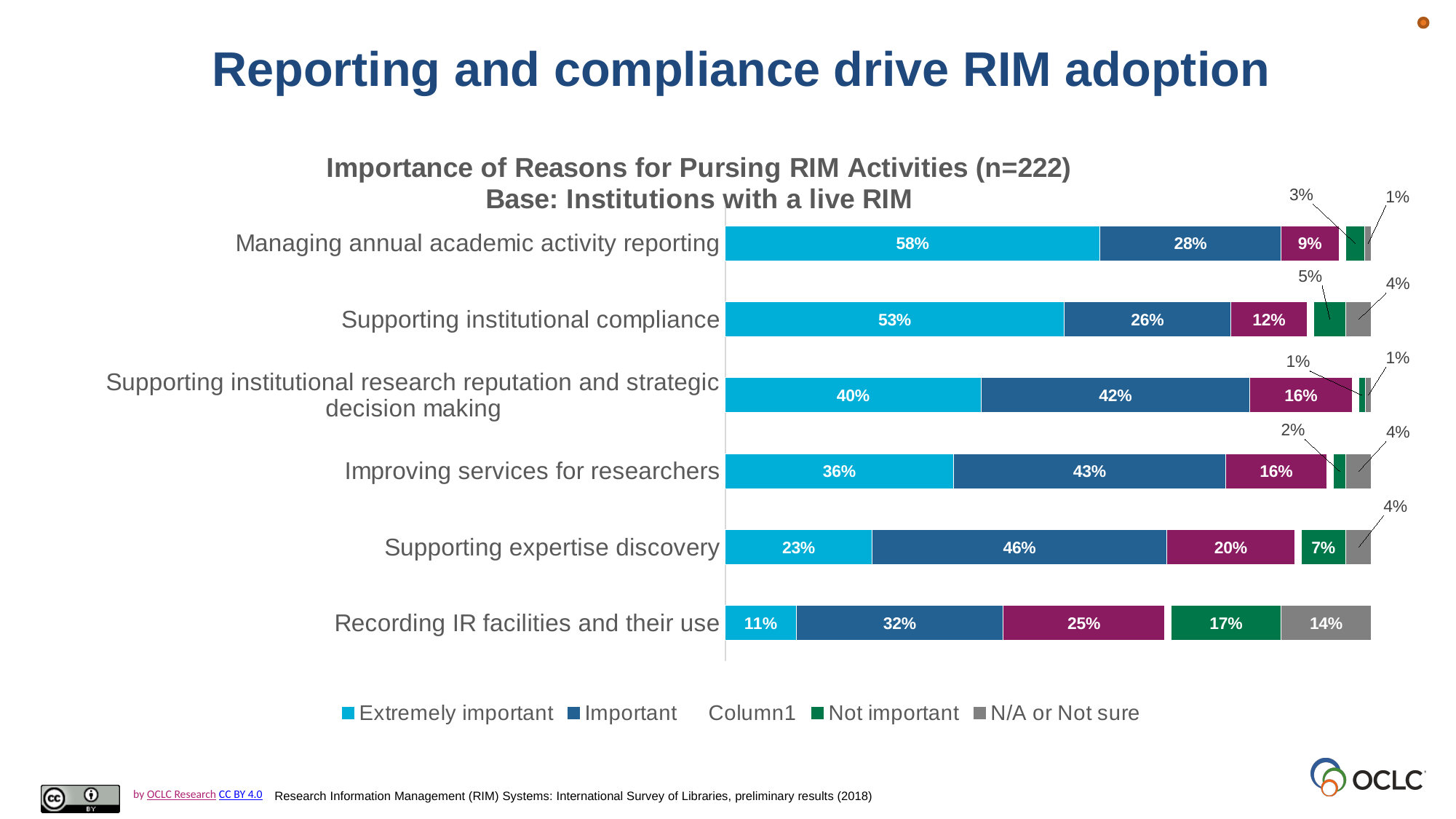
Which has a larger 'Important' value: 'Improving services for researchers' or 'Supporting institutional research reputation and strategic decision making'? Improving services for researchers What percentage rated 'Managing annual academic activity reporting' as Extremely important? 58% How many reasons (categories) are shown in the chart? 6 What is the Important value for 'Supporting expertise discovery'? 46% What type of chart is shown on the slide? Stacked bar chart What is the 'Not important' value for 'Supporting institutional compliance'? 5% Which reason has the highest 'Extremely important' percentage? Managing annual academic activity reporting How many series does the legend list? 5 What is the difference in 'Extremely important' percentage between 'Managing annual academic activity reporting' and 'Supporting institutional compliance'? 5 percentage points Which reason has the lowest 'Extremely important' percentage? Recording IR facilities and their use What is the 'N/A or Not sure' value for 'Recording IR facilities and their use'? 14% Which reason has the highest 'Not important' percentage? Recording IR facilities and their use